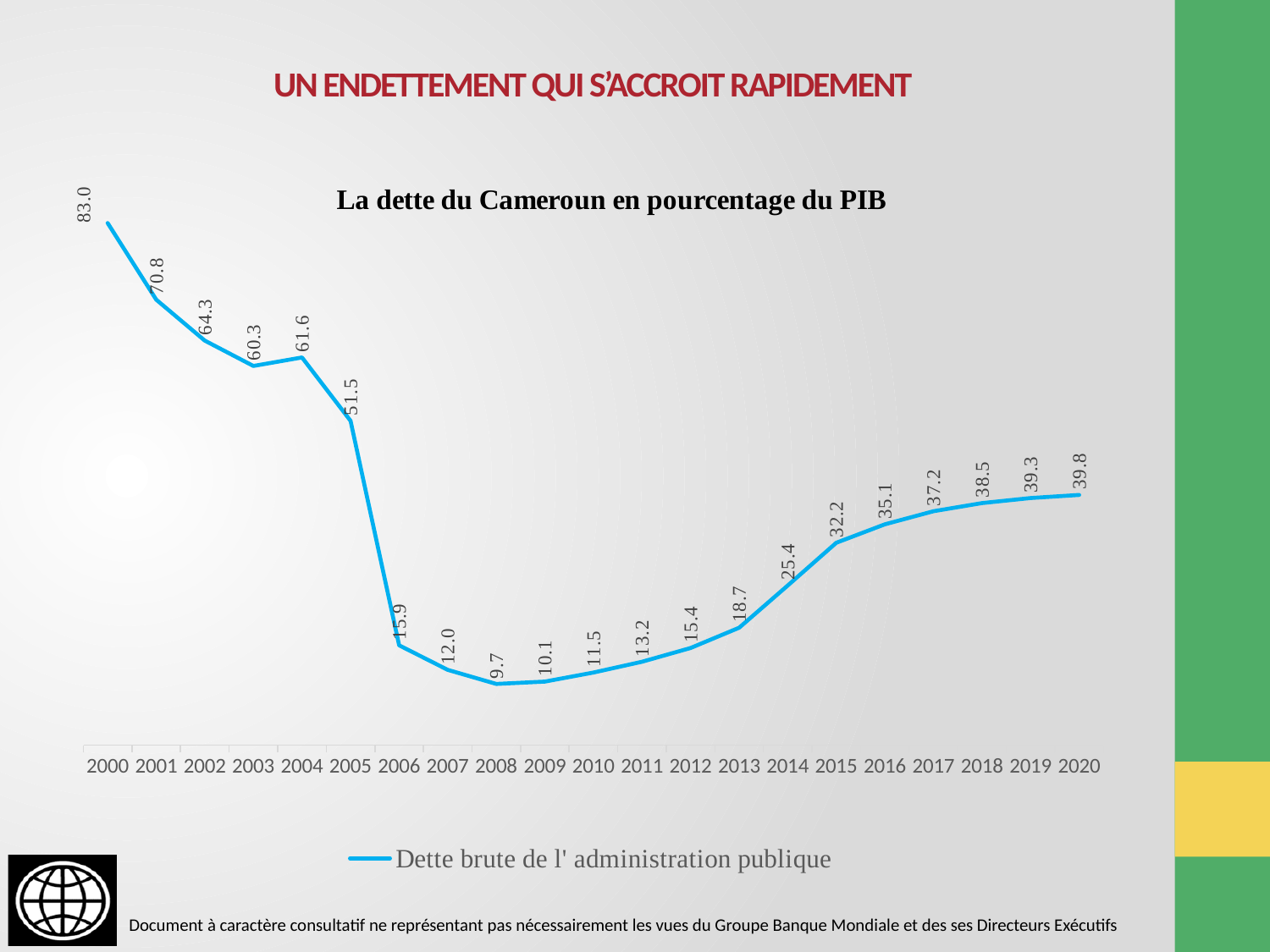
Do the values rise or fall from 2008 to 2020? rise What kind of chart is shown? line chart Which year has the lowest value? 2008 Which is larger, the value for 2004 or the value for 2003? 2004 What is the value for 2014? 25.4 What is the value for 2008? 9.7 How many series does the legend list? 1 Which year has the highest value? 2000 How many years are plotted on the x axis? 21 What is the value for 2020? 39.8 What is the value for 2000? 83.0 What is the difference between the values for 2005 and 2006? 35.6